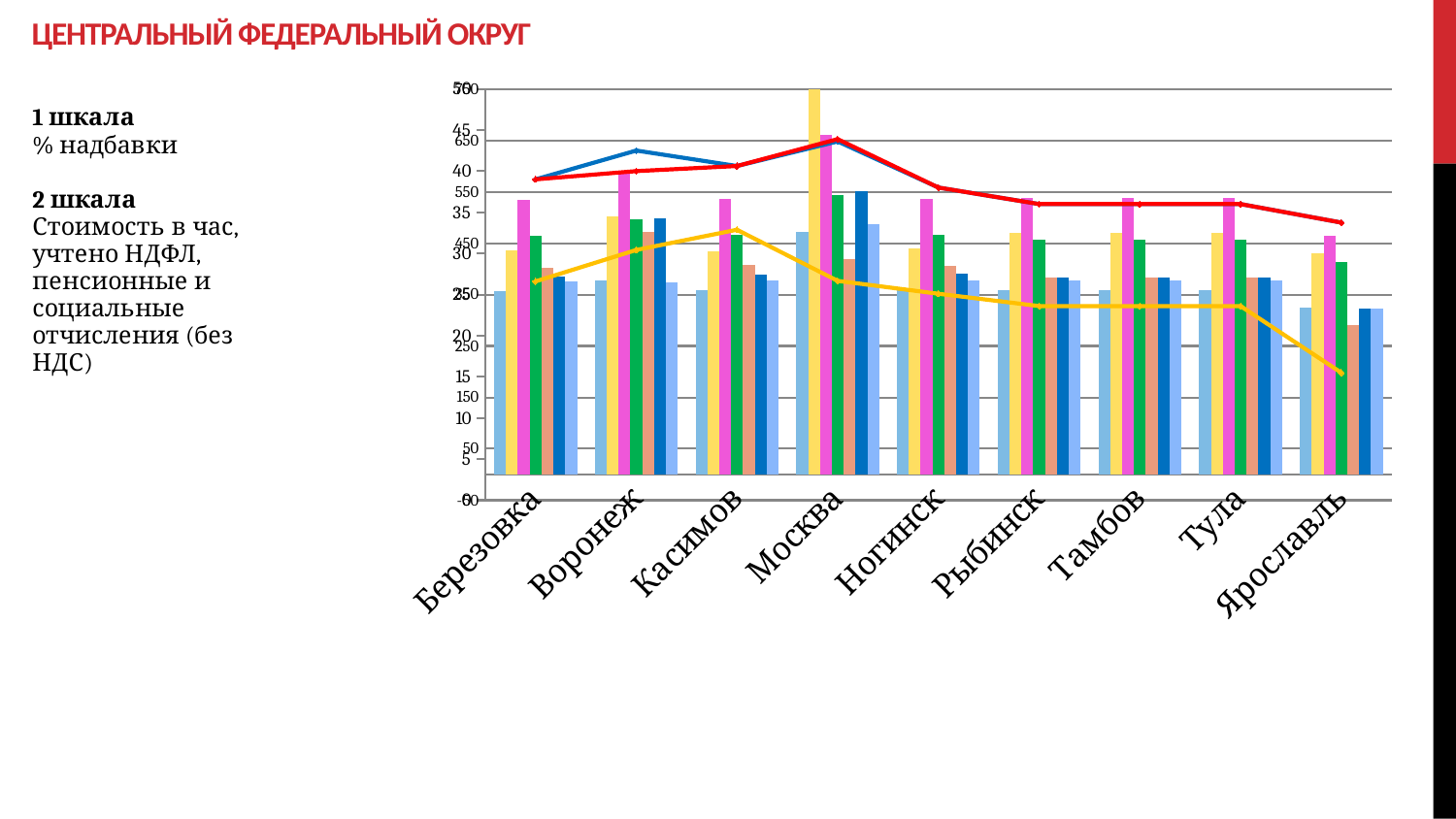
At which city does the yellow line reach its lowest point? Ярославль Which city has the tallest bar in the chart? Москва At which city does the red line reach its highest point? Москва What is the title of the slide containing the chart? ЦЕНТРАЛЬНЫЙ ФЕДЕРАЛЬНЫЙ ОКРУГ How many cities are shown along the x axis of the chart? 9 Does the red line rise or fall between Москва and Ярославль? Falls Is the yellow line higher at Касимов or at Ярославль? Касимов Is the red line higher at Москва or at Ярославль? Москва Does the yellow line rise or fall between Тула and Ярославль? Falls Which city is the first category on the x axis? Березовка How many lines are plotted over the bars in the chart? 3 What kind of chart is shown on the slide? A combined bar and line chart